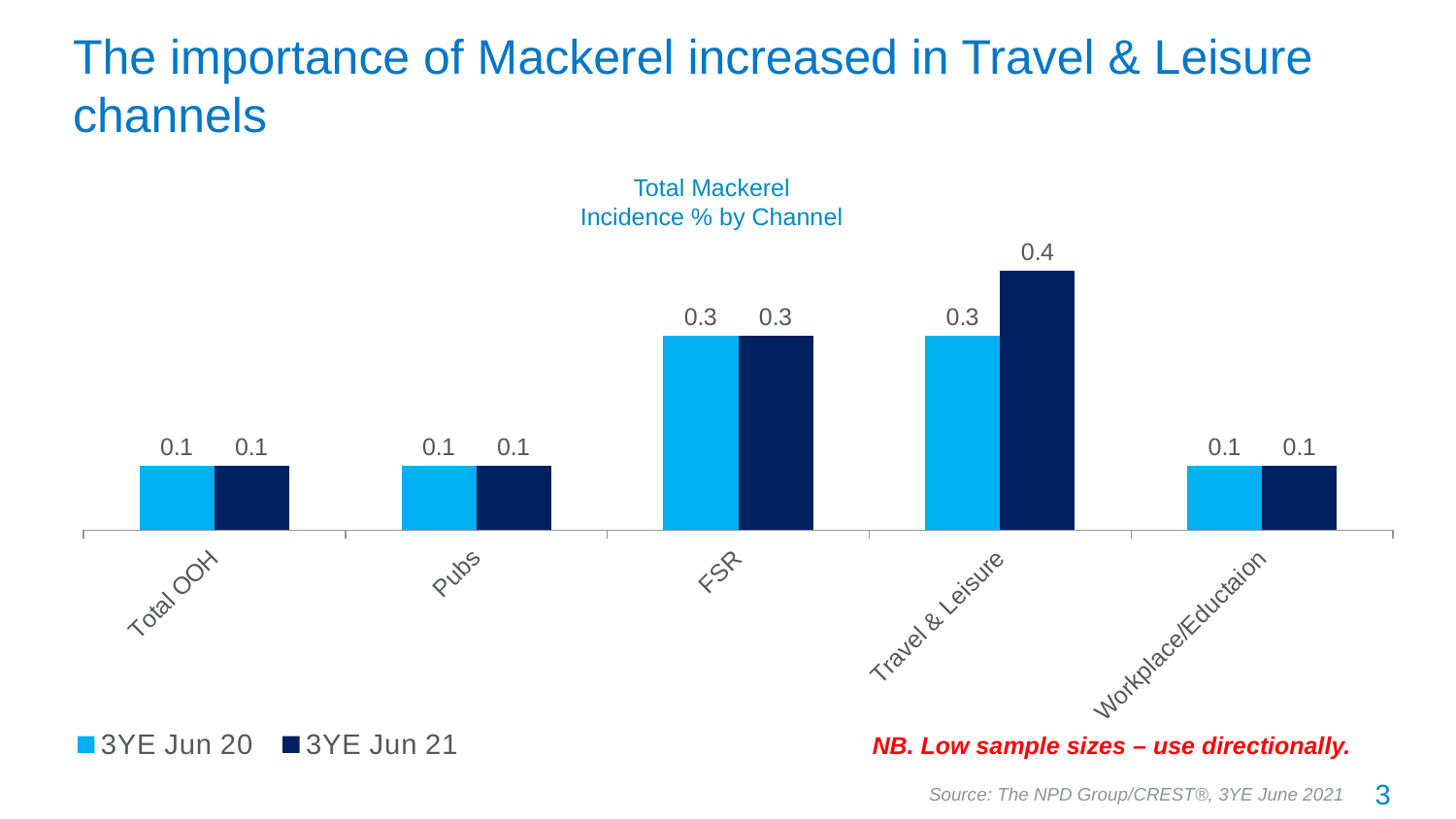
Which series is shown in dark navy blue? 3YE Jun 21 Which channel has the highest value in the 3YE Jun 21 series? Travel & Leisure What is the value for Pubs in the 3YE Jun 21 series? 0.1 How many series does the legend list? 2 What is the difference between the 3YE Jun 21 and 3YE Jun 20 values for Travel & Leisure? 0.1 How many channels are shown on the x axis? 5 What is the value for FSR in the 3YE Jun 20 series? 0.3 Which is larger for Travel & Leisure: the 3YE Jun 20 value or the 3YE Jun 21 value? 3YE Jun 21 What is the title of the chart? Total Mackerel Incidence % by Channel What kind of chart is shown on the slide? Bar chart What is the value for Travel & Leisure in the 3YE Jun 21 series? 0.4 Which is larger in the 3YE Jun 20 series: FSR or Pubs? FSR